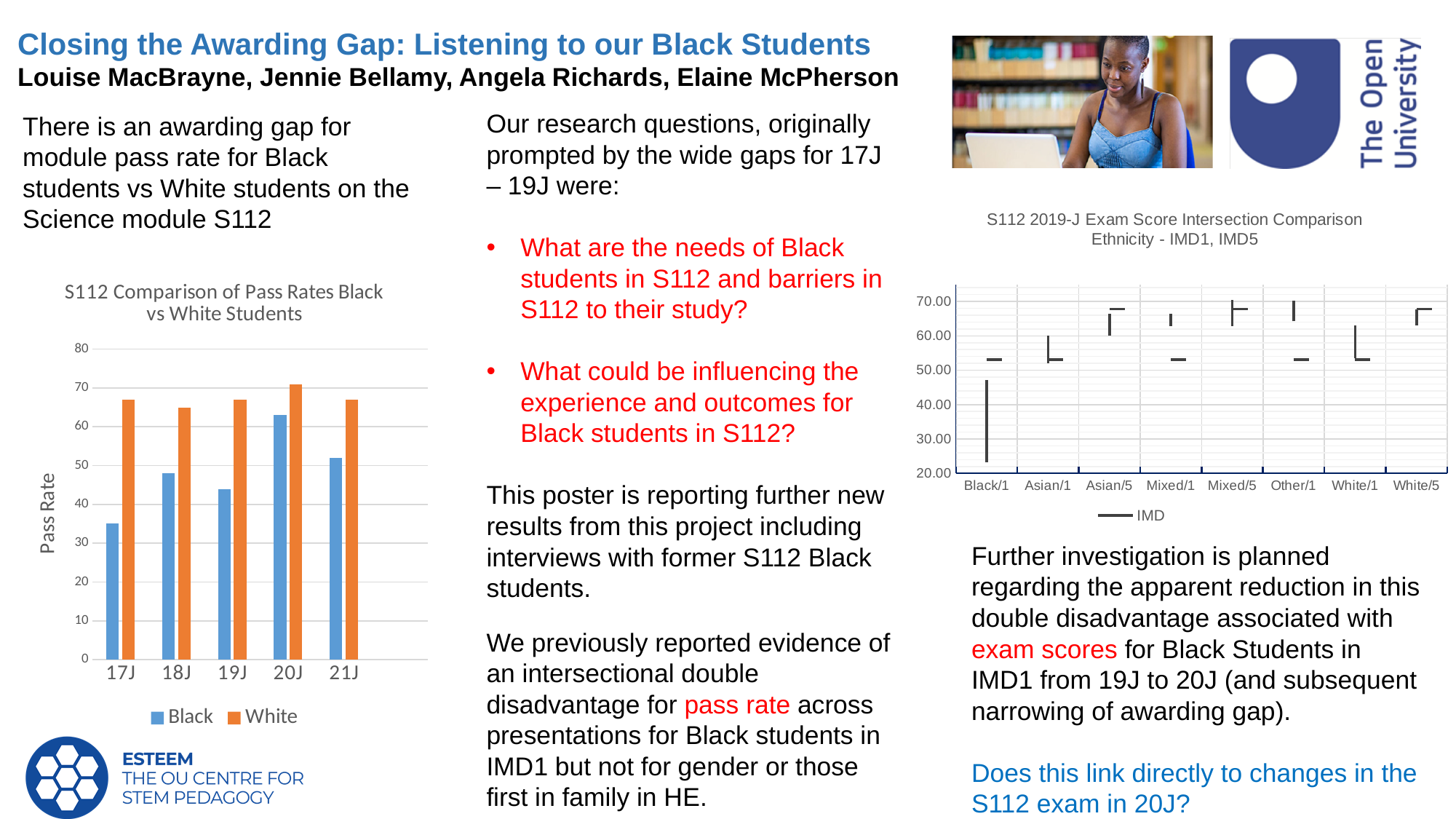
In the chart titled 'S112 Comparison of Pass Rates Black vs White Students', which presentation has the highest pass rate for Black students? 20J In the chart titled 'S112 Comparison of Pass Rates Black vs White Students', what kind of chart is shown? Bar chart In the chart titled 'S112 Comparison of Pass Rates Black vs White Students', what is the label on the vertical axis? Pass Rate In the chart titled 'S112 Comparison of Pass Rates Black vs White Students', is the pass rate for Black students in 17J greater or less than 40? less In the chart titled 'S112 Comparison of Pass Rates Black vs White Students', which presentation has the lowest pass rate for Black students? 17J In the chart titled 'S112 2019-J Exam Score Intersection Comparison Ethnicity - IMD1, IMD5', how many categories are shown on the x axis? 8 In the chart titled 'S112 2019-J Exam Score Intersection Comparison Ethnicity - IMD1, IMD5', what is the single legend entry? IMD In the chart titled 'S112 Comparison of Pass Rates Black vs White Students', how many presentation categories are shown on the x axis? 5 In the chart titled 'S112 Comparison of Pass Rates Black vs White Students', which is larger in 19J: the pass rate for Black students or for White students? White In the chart titled 'S112 Comparison of Pass Rates Black vs White Students', how many series does the legend list? 2 In the chart titled 'S112 Comparison of Pass Rates Black vs White Students', which presentation has the highest pass rate for White students? 20J